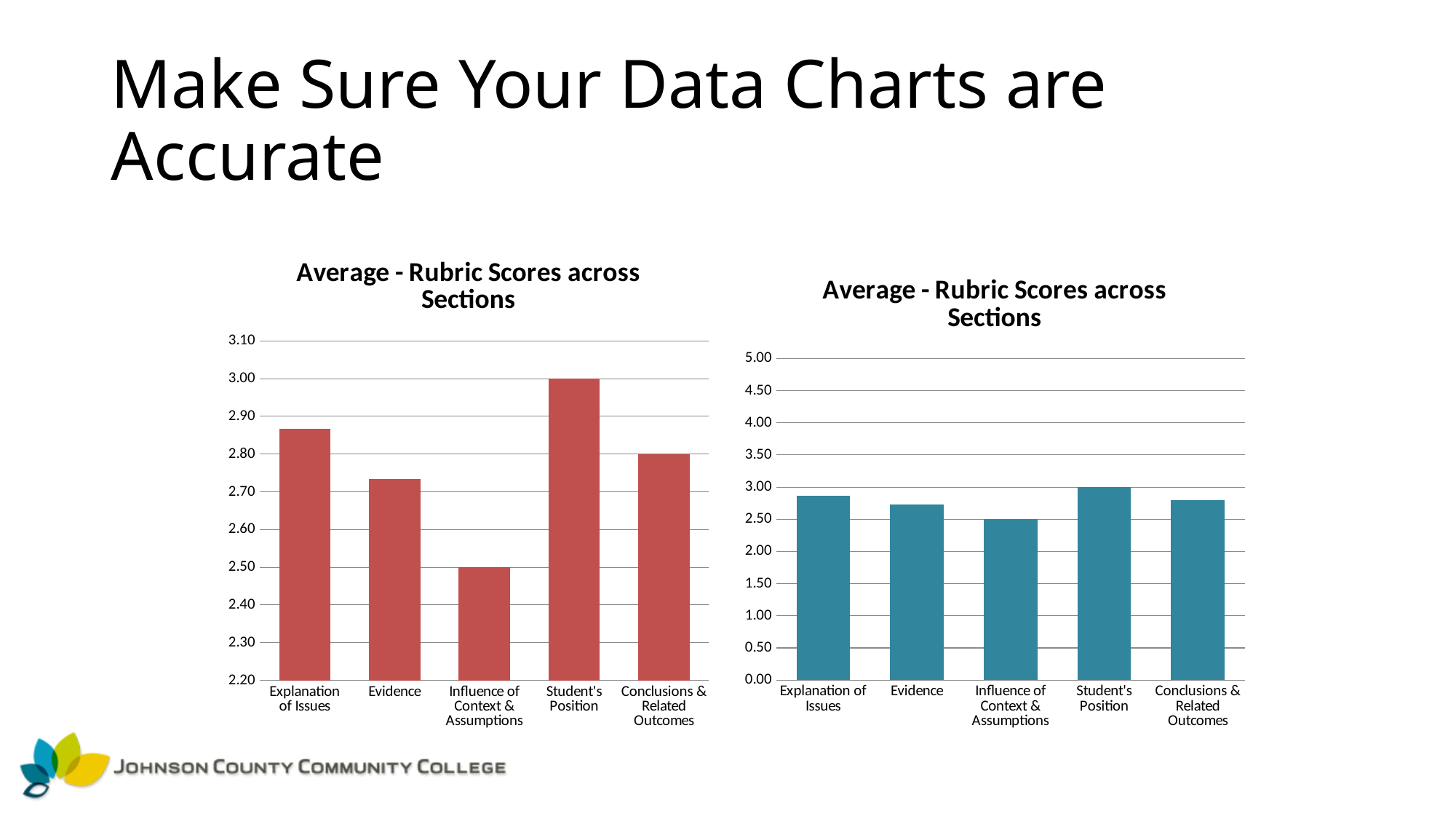
On the left chart, which is larger, the value for Explanation of Issues or the value for Evidence? Explanation of Issues On the left chart, what is the value for Student's Position? 3.00 On the left chart, is the value for Explanation of Issues greater or less than 2.80? greater How many categories are shown on the right chart? 5 On the right chart, what is the value for Student's Position? 3.00 On the right chart, is the value for Influence of Context & Assumptions greater or less than 3.00? less On the left chart, is the value for Evidence greater or less than 2.80? less What kind of chart is the right chart? bar chart On the left chart, which category has the highest value? Student's Position On the left chart, what is the value for Influence of Context & Assumptions? 2.50 On the left chart, what is the value for Conclusions & Related Outcomes? 2.80 On the left chart, which category has the lowest value? Influence of Context & Assumptions